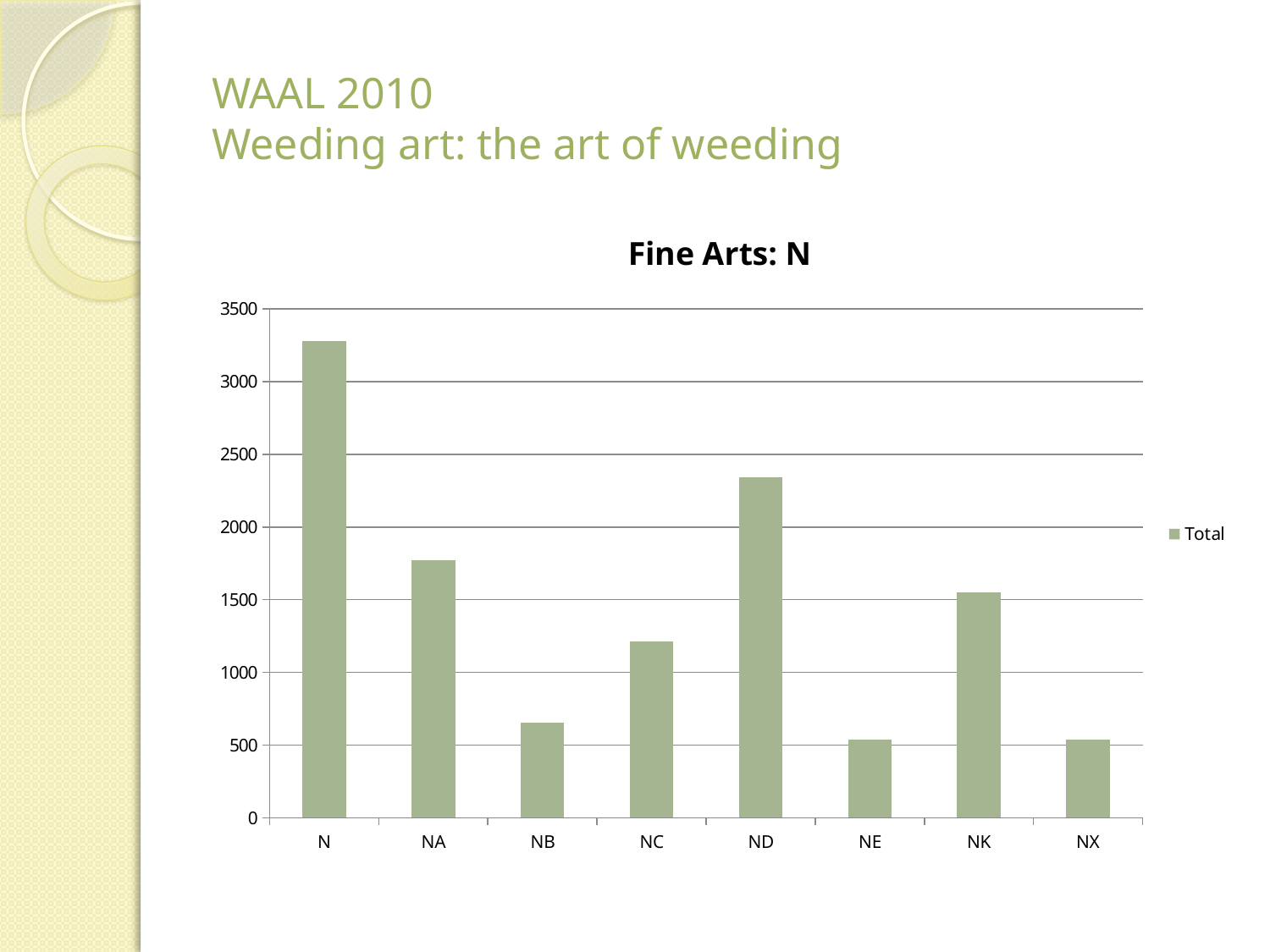
Which is larger, the value for ND or the value for NA? ND Which category has the highest value? N How many series does the legend list? 1 Is the value for NB greater or less than 1000? less Which is larger, the value for NK or the value for NC? NK Is the value for ND greater or less than 2000? greater What type of chart is shown on the slide? bar chart What is the name of the series shown in the legend? Total What is the title of the chart? Fine Arts: N Is the value for N greater or less than 3000? greater How many categories are shown on the x axis? 8